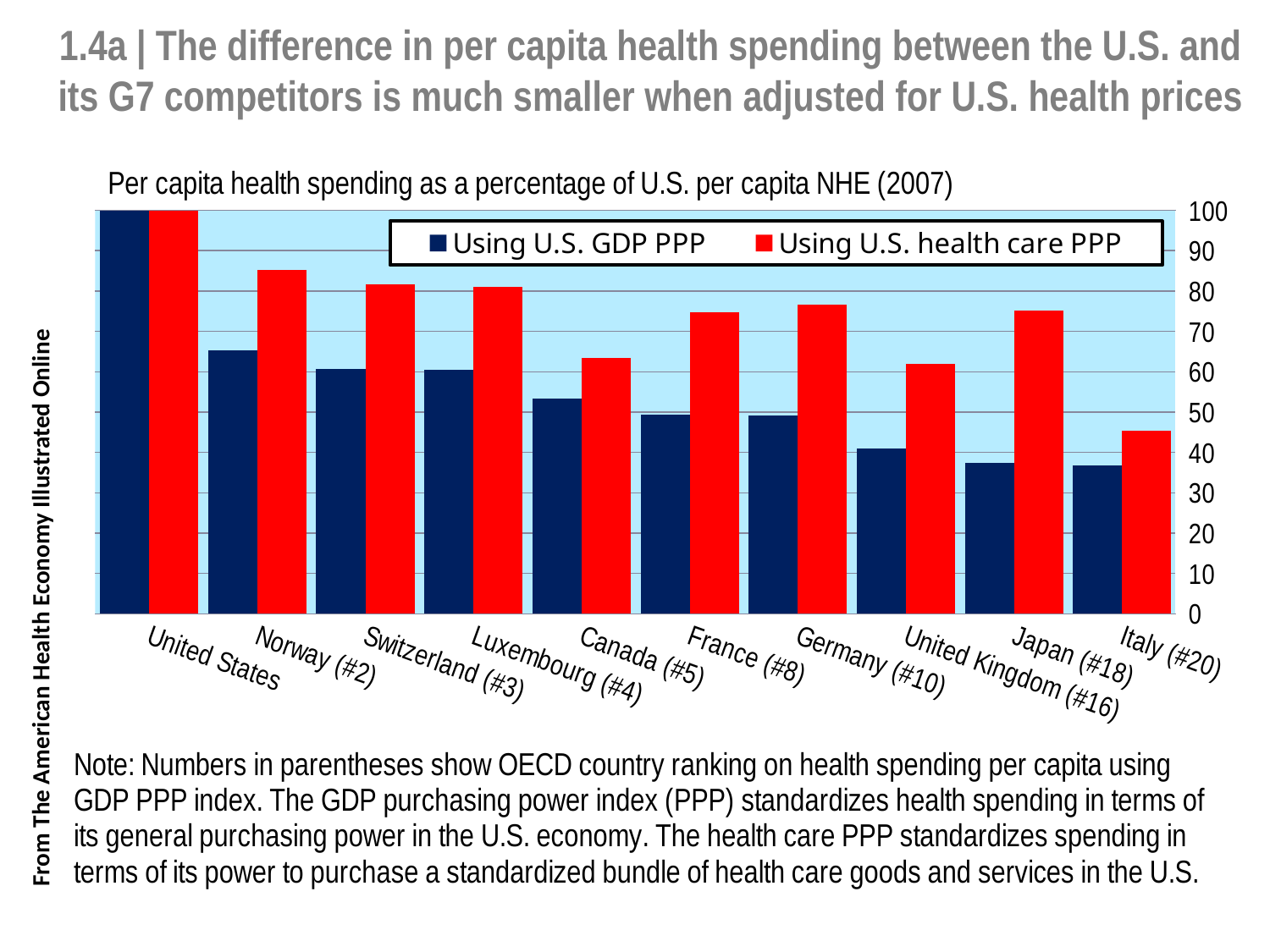
How many countries are shown on the x axis of the chart? 10 Which country has the highest value using U.S. health care PPP? United States Which is larger: the value for Norway (#2) using U.S. GDP PPP or the value for Canada (#5) using U.S. GDP PPP? Norway (#2) Is the value for Norway (#2) using U.S. health care PPP greater or less than 80? greater What is the value for the United States using U.S. GDP PPP? 100 What kind of chart is shown on the slide? bar chart Is the value for Japan (#18) using U.S. GDP PPP greater or less than 40? less Which country has the lowest value using U.S. health care PPP? Italy (#20) Is the value for Canada (#5) using U.S. GDP PPP greater or less than 50? greater What are the two series named in the legend? Using U.S. GDP PPP; Using U.S. health care PPP How many series does the legend list? 2 Do the values using U.S. GDP PPP generally rise or fall from left to right across the countries? fall